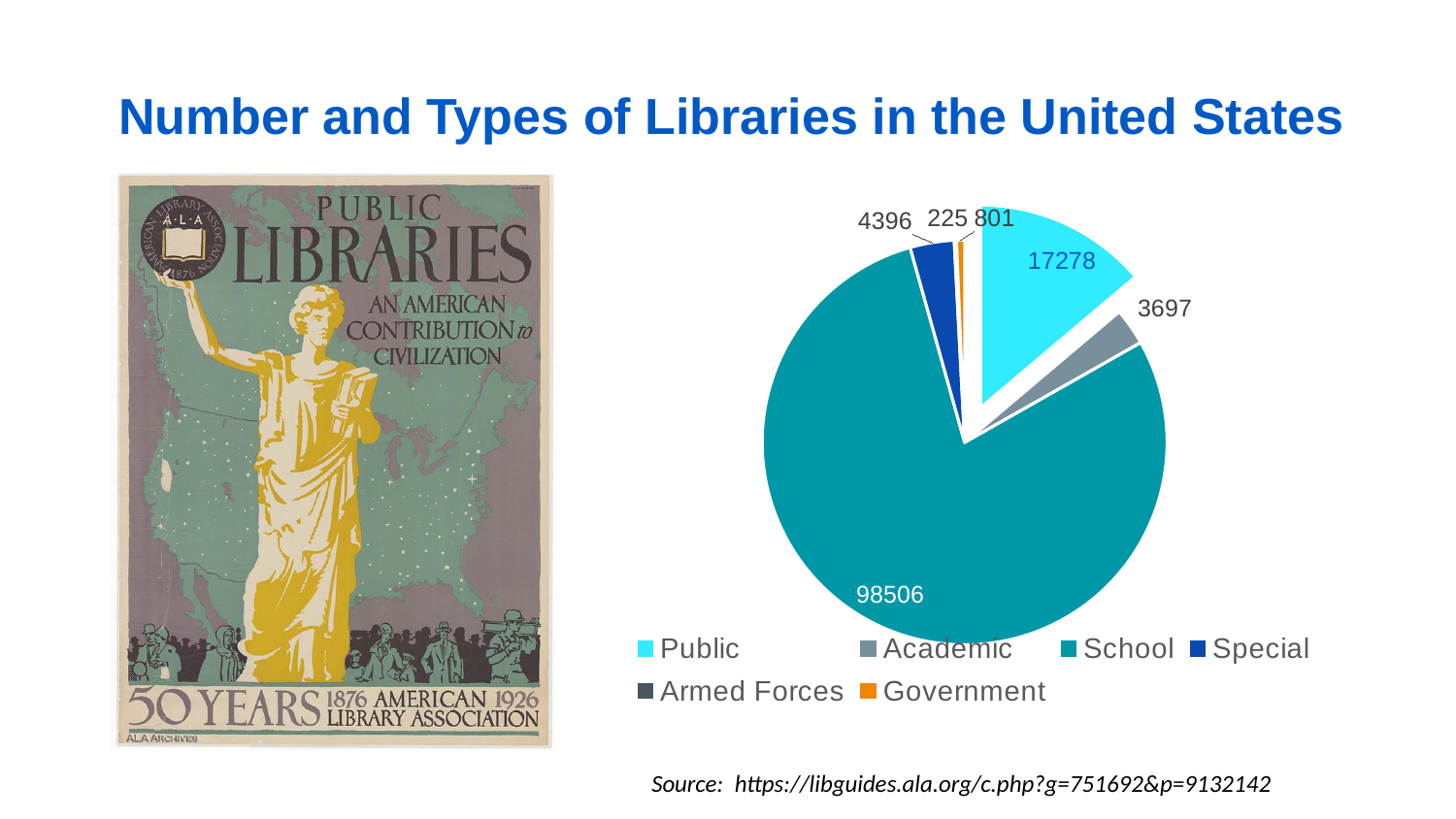
What is the value for Special libraries in the pie chart? 4396 Which library type has the largest slice in the pie chart? School Which library type has the smallest slice in the pie chart? Armed Forces What is the value for Armed Forces libraries in the pie chart? 225 What type of chart is shown on the slide? Pie chart Which colour represents Government in the pie chart? Orange What is the value for Public libraries in the pie chart? 17278 What is the difference between the School and Public values in the pie chart? 81228 Which is larger in the pie chart, Special or Academic? Special What is the value for School libraries in the pie chart? 98506 What is the value for Academic libraries in the pie chart? 3697 How many categories does the pie chart show? 6